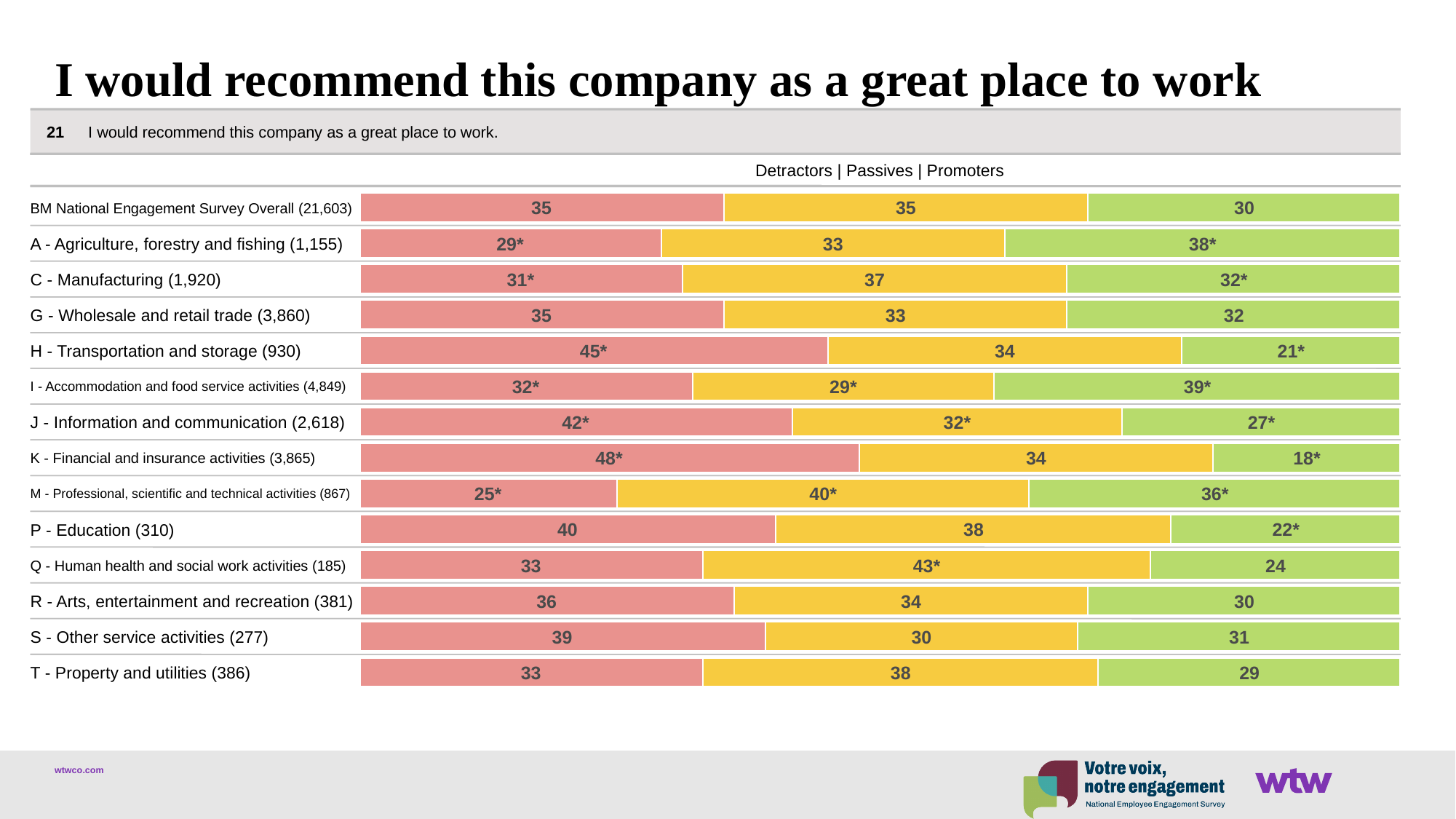
Which category has the lowest Promoters value? K - Financial and insurance activities What kind of chart is shown on the slide? Stacked bar chart What is the Promoters value for BM National Engagement Survey Overall? 30 What is the total of the stacked bar for S - Other service activities? 100 Which is larger: the Promoters value for I - Accommodation and food service activities or for P - Education? I - Accommodation and food service activities What is the difference between the Detractors values for K - Financial and insurance activities and M - Professional, scientific and technical activities? 23 How many categories (bars) are shown in the chart? 14 How many series does the chart show per bar? 3 What is the Promoters value for A - Agriculture, forestry and fishing? 38* What is the Detractors value for H - Transportation and storage? 45* Which category has the highest Detractors value? K - Financial and insurance activities What is the Passives value for Q - Human health and social work activities? 43*